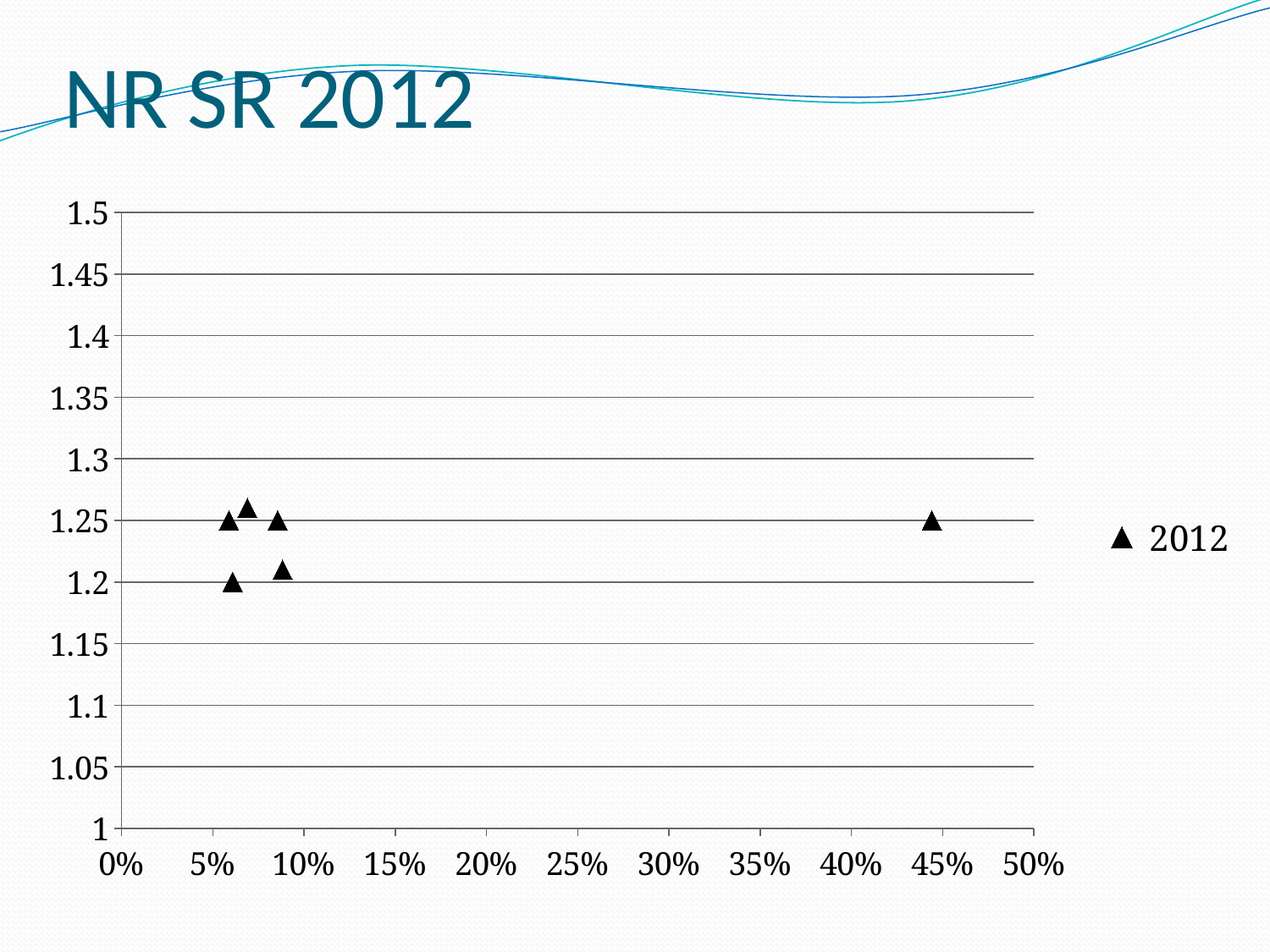
What is the title of the slide containing the chart? NR SR 2012 How many points have a horizontal value below 10%? 5 Is the vertical value of the rightmost point (near 45%) greater or less than 1.2? greater How many data points are plotted on the chart? 6 Is the horizontal value of the rightmost point greater or less than 40%? greater What kind of chart is shown on the slide? scatter chart How many series does the legend list? 1 Is the vertical value of the highest point on the chart greater or less than 1.3? less What is the name of the series shown in the legend? 2012 What is the highest value shown on the vertical axis? 1.5